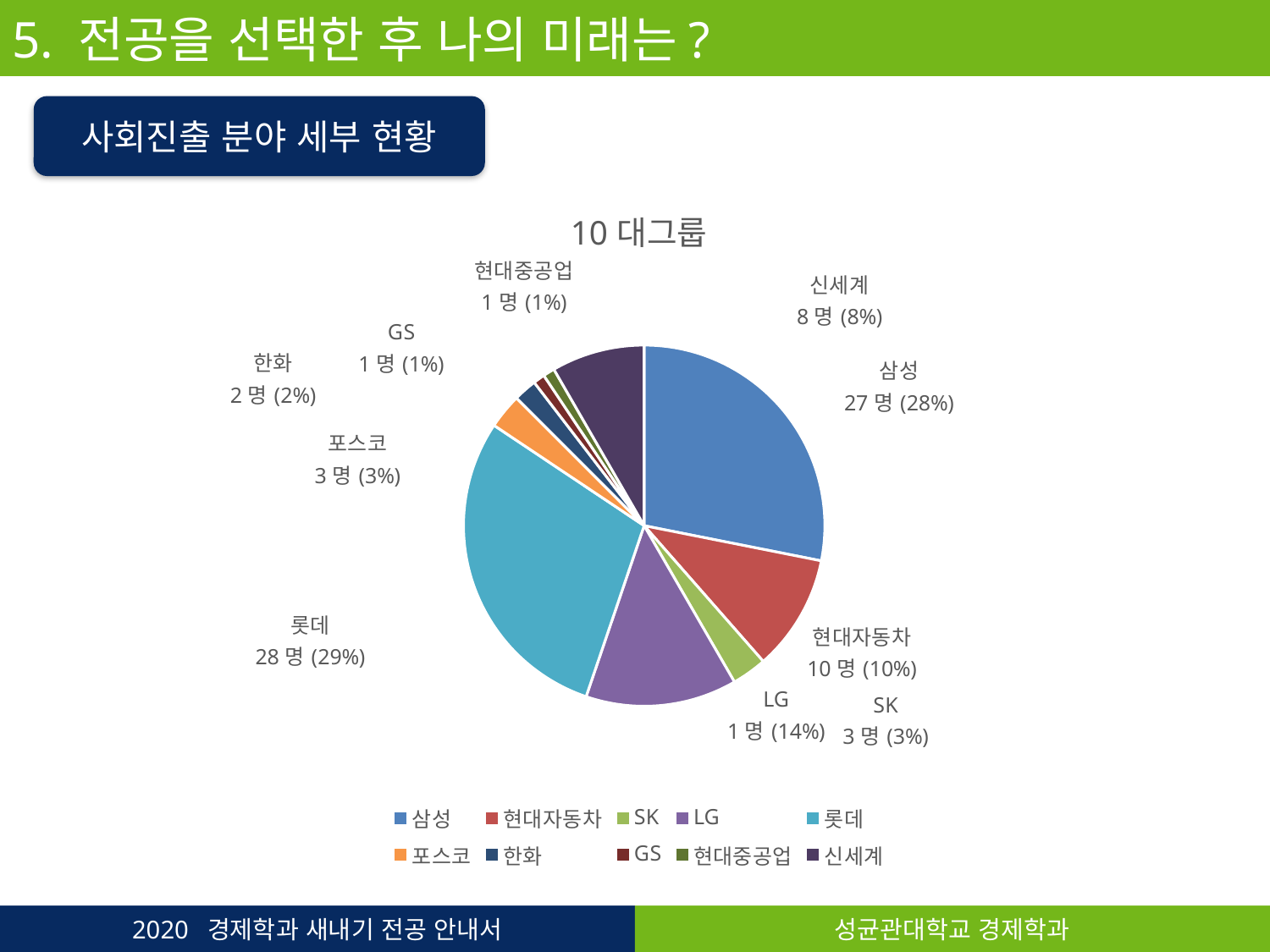
How many entries does the legend list? 10 Which is larger, the 포스코 slice or the 한화 slice? 포스코 How many people are in the 삼성 slice? 27 명 What is the title of the chart? 10 대그룹 What kind of chart is shown on the slide? pie chart What percentage share does 현대자동차 have? 10% How many slices does the pie chart have? 10 What percentage share does LG have? 14% What percentage share does 신세계 have? 8% Which group has the largest slice? 롯데 How many people are in the 롯데 slice? 28 명 What is the difference in number of people between 삼성 and 현대자동차? 17 명